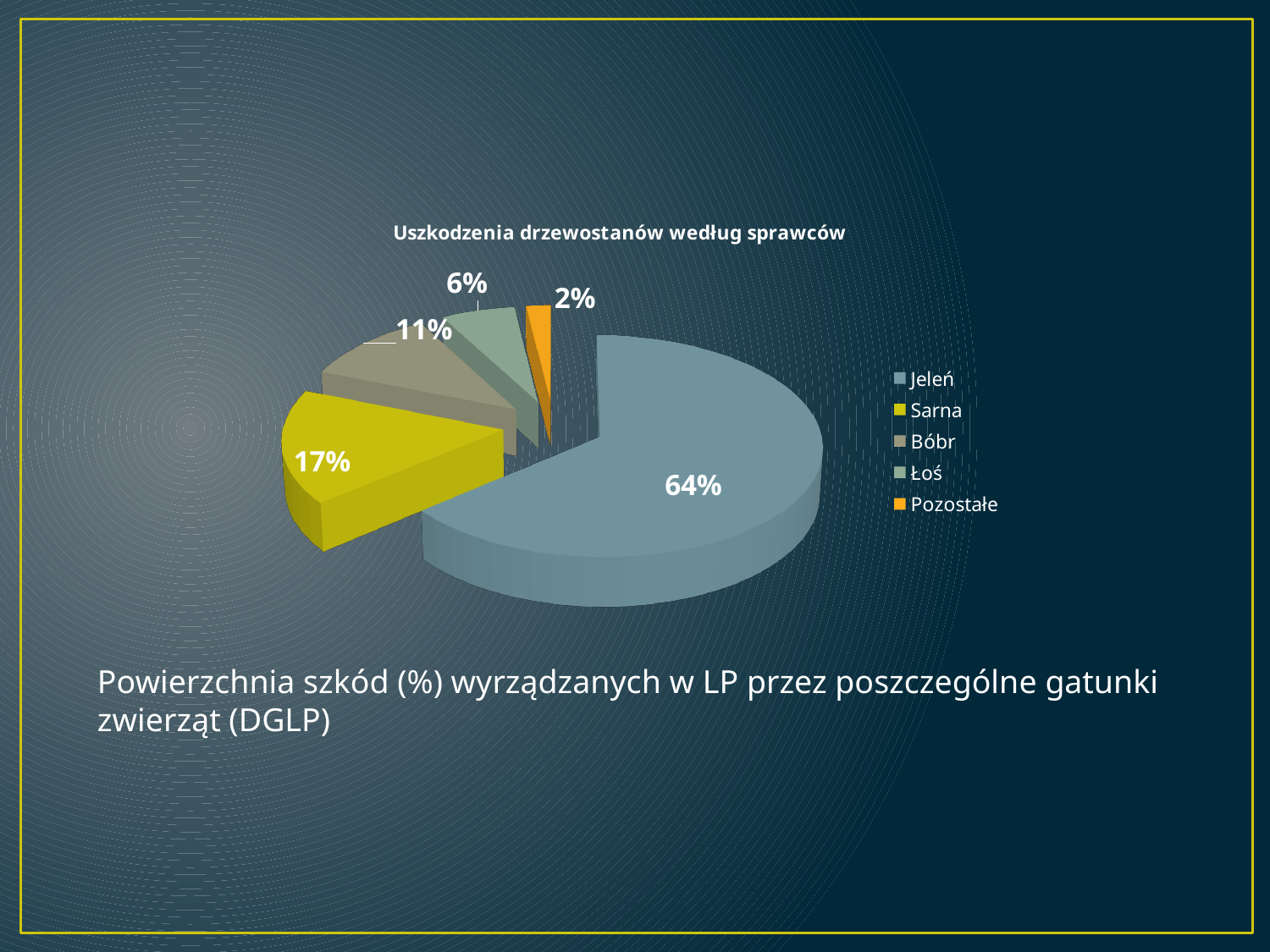
What is the title of the chart? Uszkodzenia drzewostanów według sprawców What share of the pie does Jeleń account for? 64% Which category has the largest slice of the pie? Jeleń What is the value shown for Sarna? 17% What is the value shown for Łoś? 6% What is the value shown for Pozostałe? 2% Which is larger, the share for Bóbr or the share for Łoś? Bóbr How many categories does the pie chart show? 5 What is the value shown for Bóbr? 11% What is the difference between the Jeleń and Sarna shares? 47% What kind of chart is shown on the slide? Pie chart Which category has the smallest slice of the pie? Pozostałe